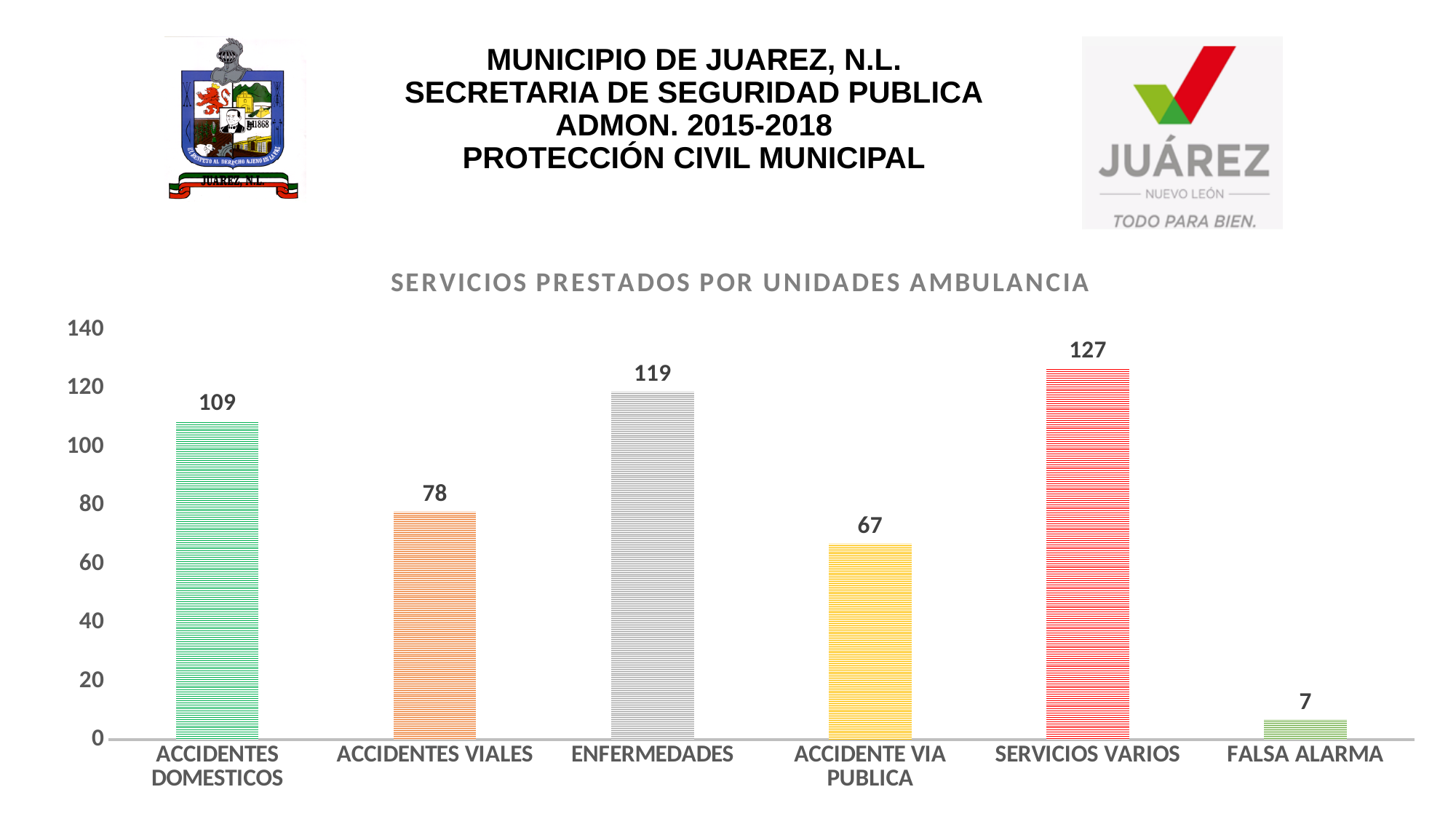
Which is larger, ACCIDENTES DOMESTICOS or ENFERMEDADES? ENFERMEDADES Is the value for ACCIDENTE VIA PUBLICA greater or less than 80? less What is the value for FALSA ALARMA? 7 What is the difference between SERVICIOS VARIOS and ACCIDENTES DOMESTICOS? 18 What is the value for ACCIDENTES VIALES? 78 What kind of chart is shown on the slide? bar chart How many categories are shown in the chart? 6 What is the difference between ENFERMEDADES and ACCIDENTE VIA PUBLICA? 52 What is the value for ENFERMEDADES? 119 Which category has the highest value? SERVICIOS VARIOS What is the title of the chart? SERVICIOS PRESTADOS POR UNIDADES AMBULANCIA Which category has the lowest value? FALSA ALARMA